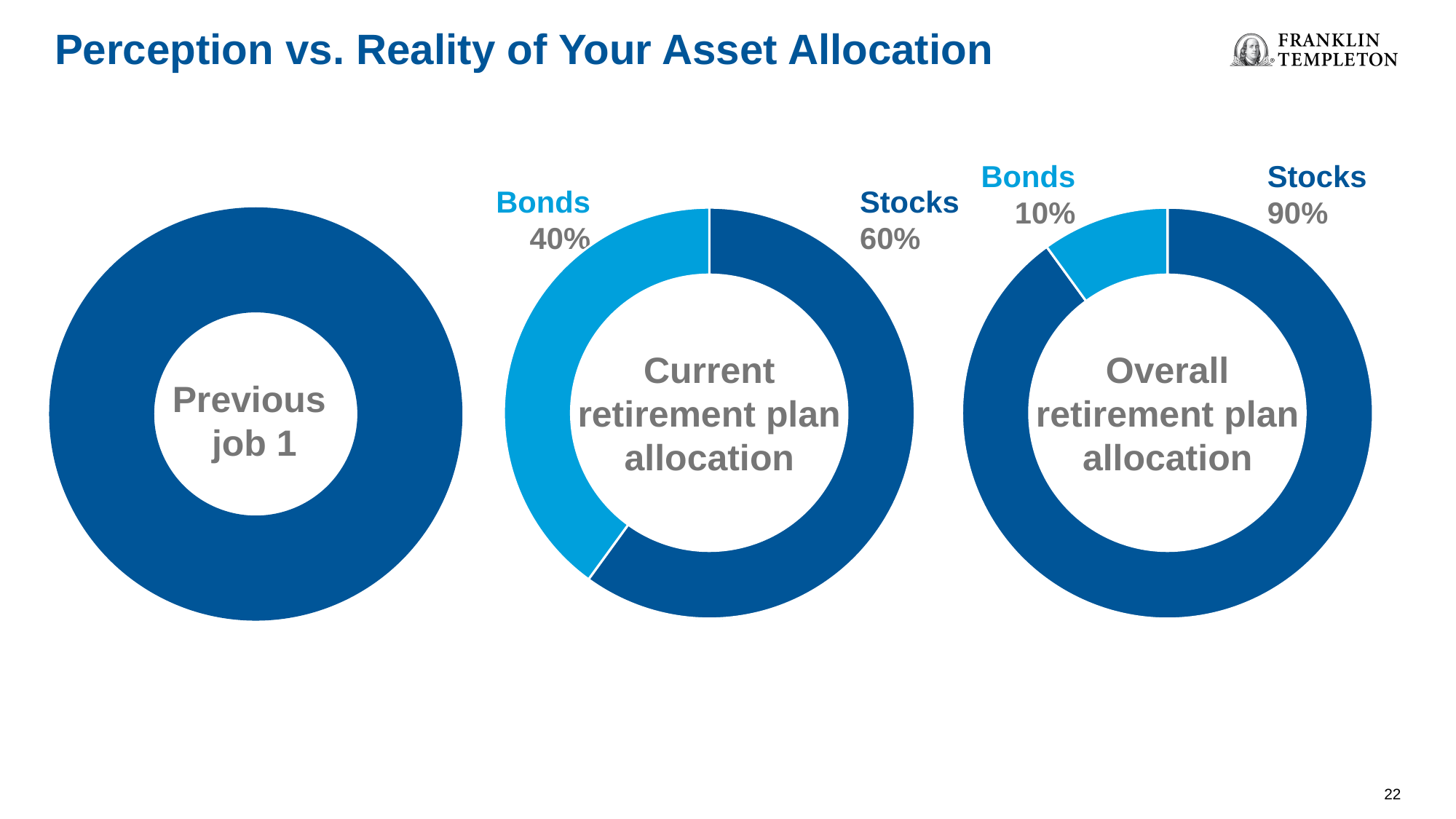
In the 'Overall retirement plan allocation' chart, which category has the largest share? Stocks In the 'Current retirement plan allocation' chart, what share is allocated to Bonds? 40% How many categories are shown in the 'Current retirement plan allocation' chart? 2 In the 'Current retirement plan allocation' chart, what share is allocated to Stocks? 60% In the 'Overall retirement plan allocation' chart, what is the difference between the Stocks share and the Bonds share? 80% In the 'Current retirement plan allocation' chart, what is the difference between the Stocks share and the Bonds share? 20% What is the title of the slide? Perception vs. Reality of Your Asset Allocation What kind of chart is the 'Overall retirement plan allocation' chart? Doughnut chart In the 'Current retirement plan allocation' chart, which category has the smallest share? Bonds In the 'Overall retirement plan allocation' chart, what share is allocated to Stocks? 90% In the 'Overall retirement plan allocation' chart, what share is allocated to Bonds? 10% Is the Bonds share larger in the 'Current retirement plan allocation' chart or in the 'Overall retirement plan allocation' chart? Current retirement plan allocation